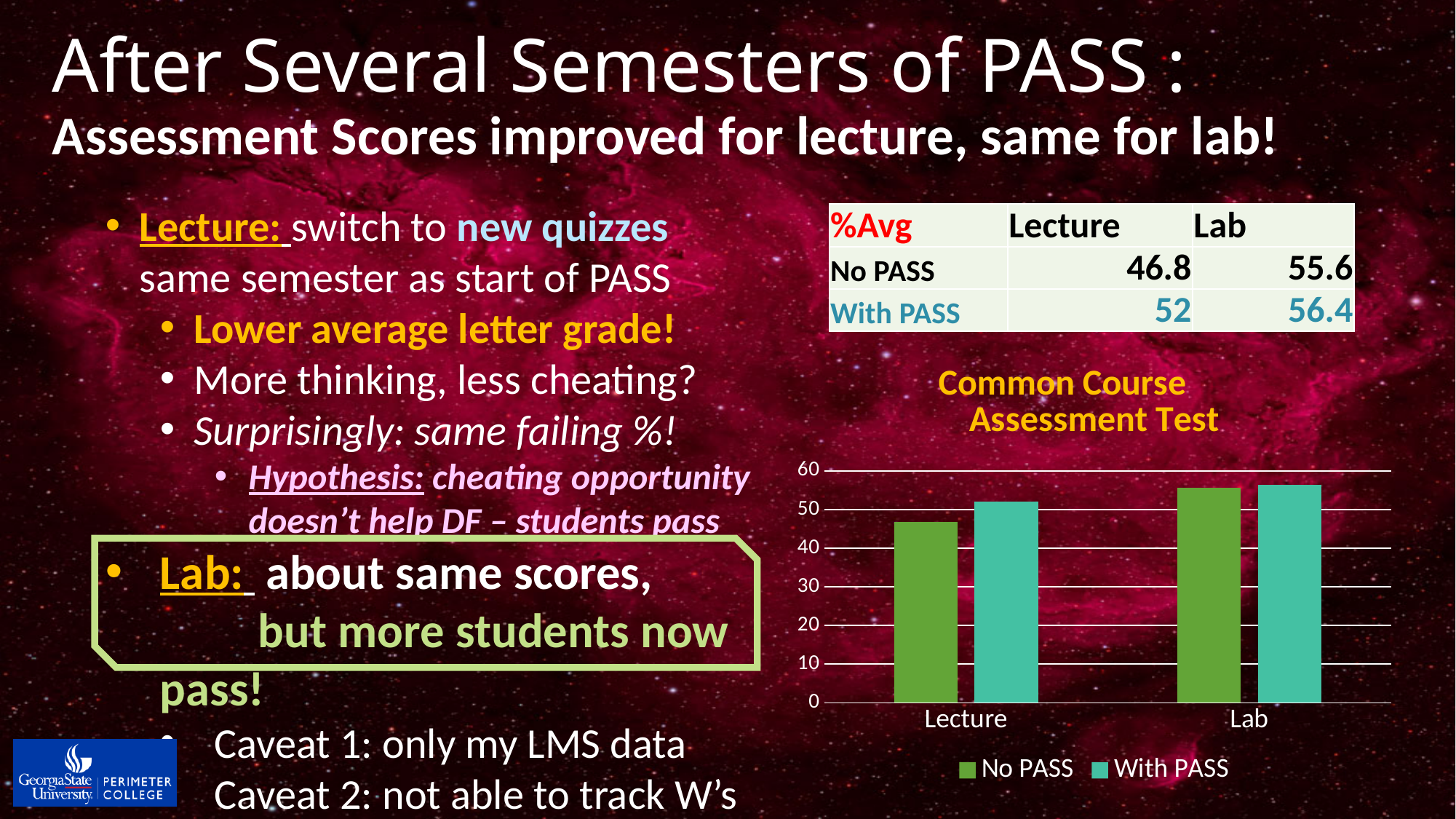
In the Common Course Assessment Test chart, what is the No PASS value for Lab? 55.6 In the Common Course Assessment Test chart, is the No PASS value for Lecture greater or less than 50? less In the Common Course Assessment Test chart, which is larger for Lecture: No PASS or With PASS? With PASS How many series does the legend of the Common Course Assessment Test chart list? 2 In the Common Course Assessment Test chart, what is the With PASS value for Lecture? 52 What type of chart is the Common Course Assessment Test chart? bar chart In the Common Course Assessment Test chart, what is the No PASS value for Lecture? 46.8 In the Common Course Assessment Test chart, what is the difference between the With PASS and No PASS values for Lecture? 5.2 What is the title of the chart on the slide? Common Course Assessment Test In the Common Course Assessment Test chart, what is the With PASS value for Lab? 56.4 How many categories are shown on the x axis of the Common Course Assessment Test chart? 2 In the Common Course Assessment Test chart, is the With PASS value for Lab greater or less than 50? greater